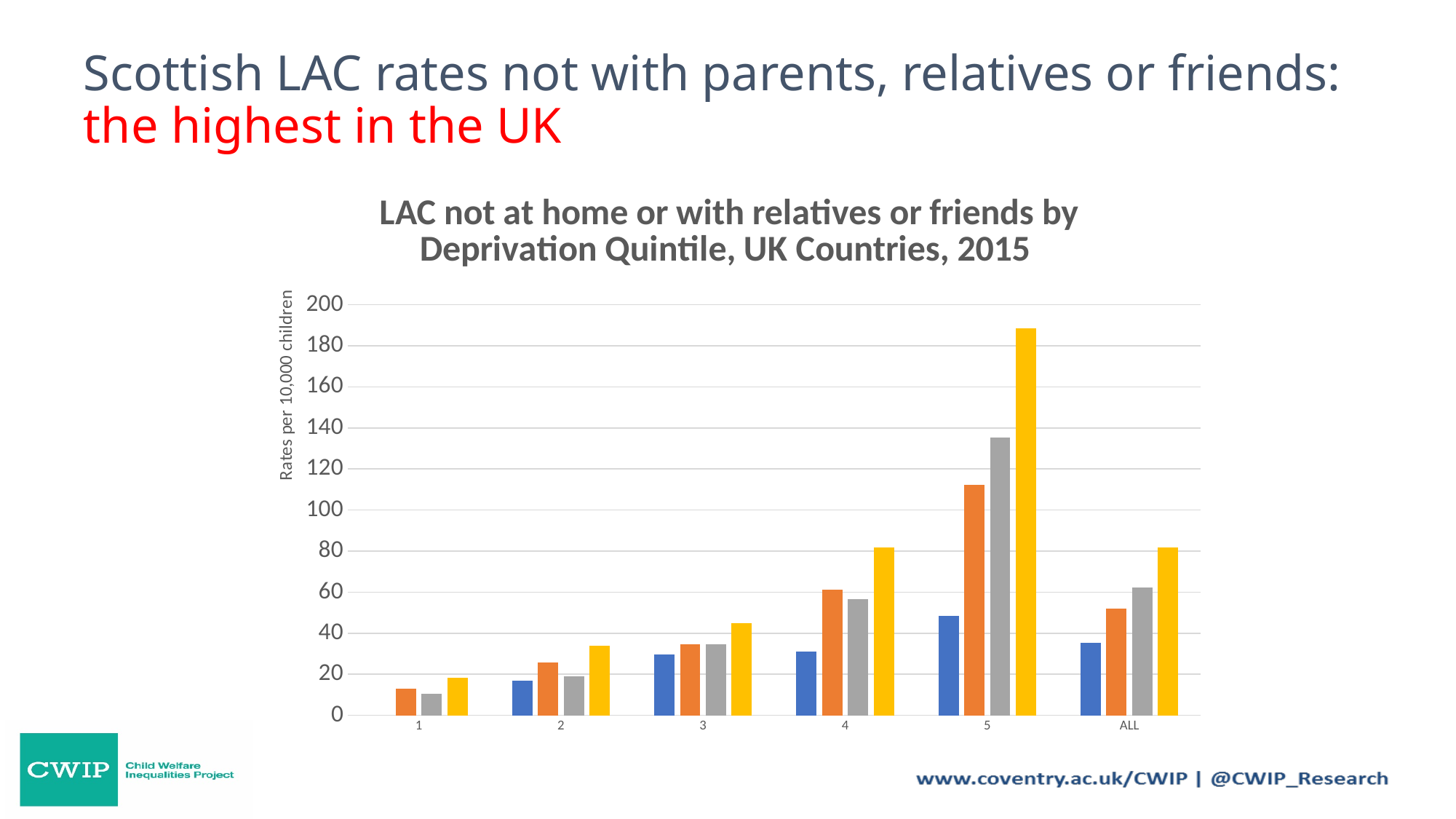
What is the label on the vertical axis of the chart? Rates per 10,000 children In category 5, which is larger: the yellow bar or the grey bar? the yellow bar Is the value of the blue bar for category ALL greater or less than 40? less Is the value of the grey bar for category 5 greater or less than 140? less What is the title of the chart? LAC not at home or with relatives or friends by Deprivation Quintile, UK Countries, 2015 Which x-axis category contains the tallest bar in the chart? 5 How many categories are shown along the x axis of the chart? 6 Is the value of the orange bar for category 5 greater or less than 100? greater What kind of chart is shown on the slide? bar chart Do the yellow bars rise or fall from category 1 to category 5? rise